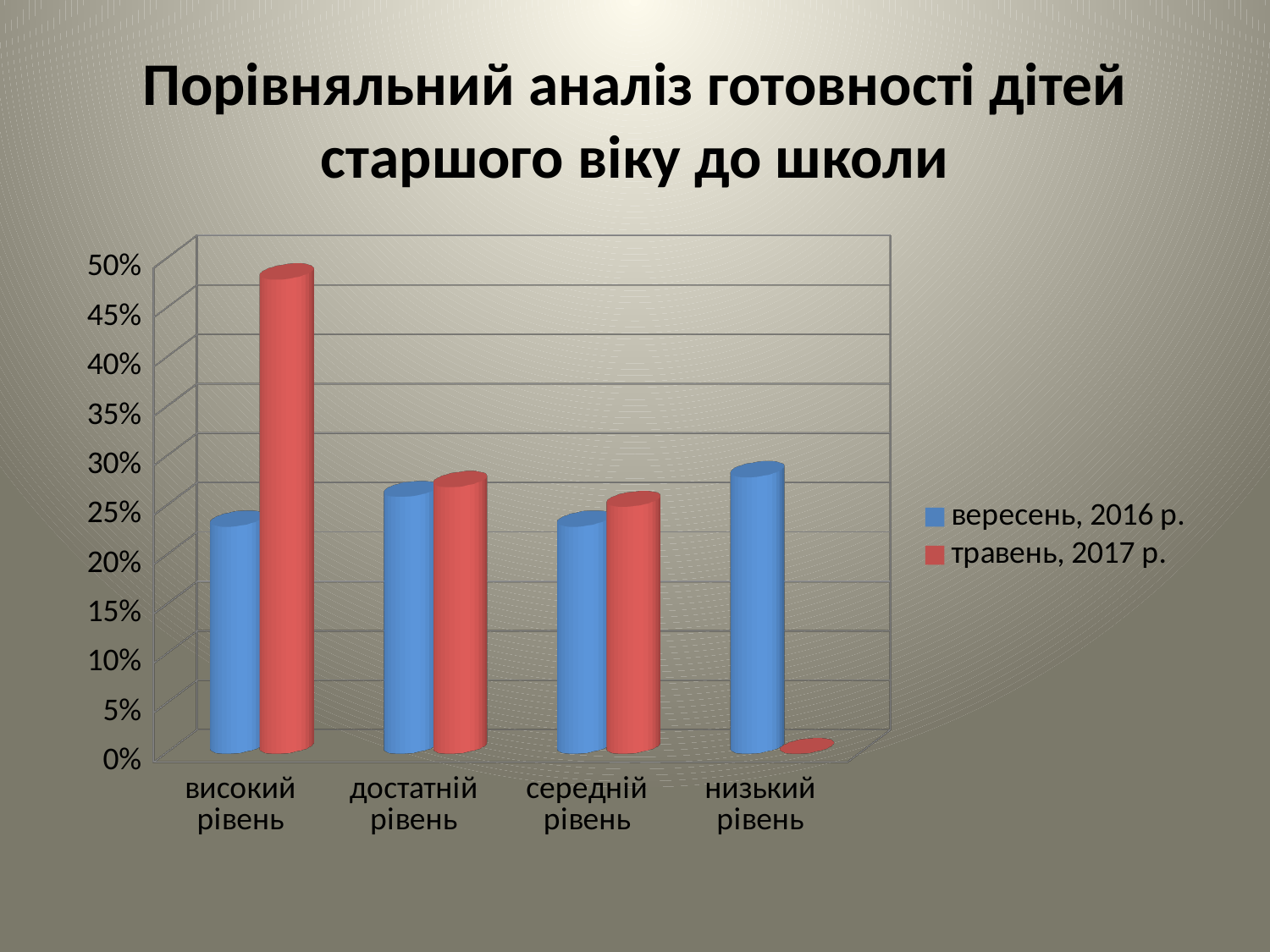
What colour are the bars for the series травень, 2017 р.? red For високий рівень, which series has the larger value: вересень, 2016 р. or травень, 2017 р.? травень, 2017 р. Which category has the highest value for травень, 2017 р.? високий рівень Is the value for низький рівень in вересень, 2016 р. greater or less than 20%? greater How many series does the legend list? 2 Is the value for високий рівень in вересень, 2016 р. greater or less than 30%? less Which category has the lowest value for травень, 2017 р.? низький рівень How many categories (levels) are shown on the x axis? 4 What kind of chart is shown on the slide? bar chart For низький рівень, which series has the larger value: вересень, 2016 р. or травень, 2017 р.? вересень, 2016 р. Is the value for високий рівень in травень, 2017 р. greater or less than 40%? greater